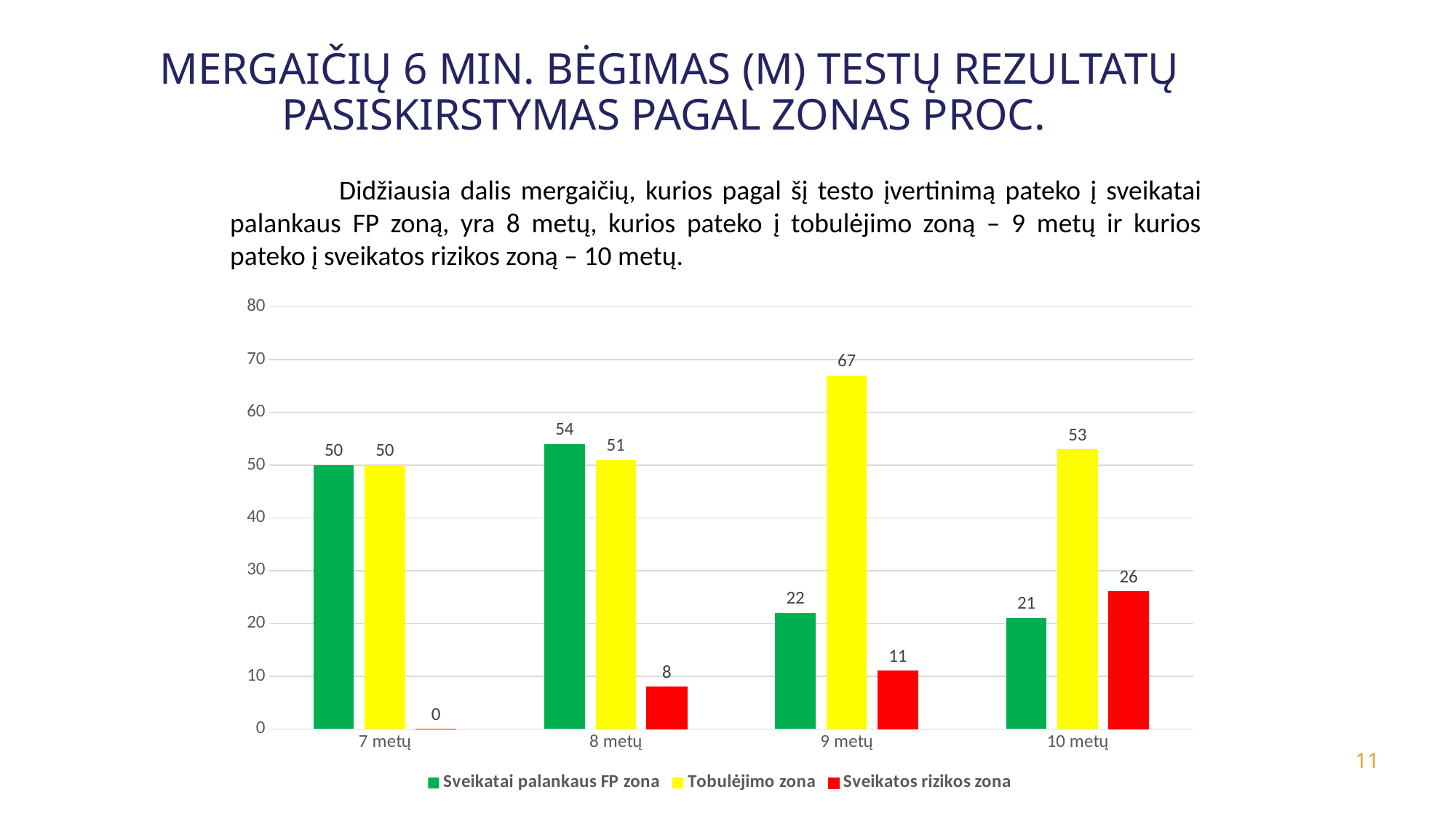
What is the difference between the Tobulėjimo zona and Sveikatai palankaus FP zona values at 9 metų? 45 What is the value for Sveikatos rizikos zona at 10 metų? 26 What is the value for Sveikatos rizikos zona at 7 metų? 0 What colour represents Sveikatos rizikos zona in the chart? red What is the value for Sveikatai palankaus FP zona at 8 metų? 54 How many age groups are shown on the x axis? 4 How many series does the legend list? 3 Which is larger at 8 metų: Sveikatai palankaus FP zona or Tobulėjimo zona? Sveikatai palankaus FP zona Which age group has the highest value for Tobulėjimo zona? 9 metų What kind of chart is shown on the slide? bar chart What is the value for Tobulėjimo zona at 9 metų? 67 Which age group has the lowest value for Sveikatai palankaus FP zona? 10 metų